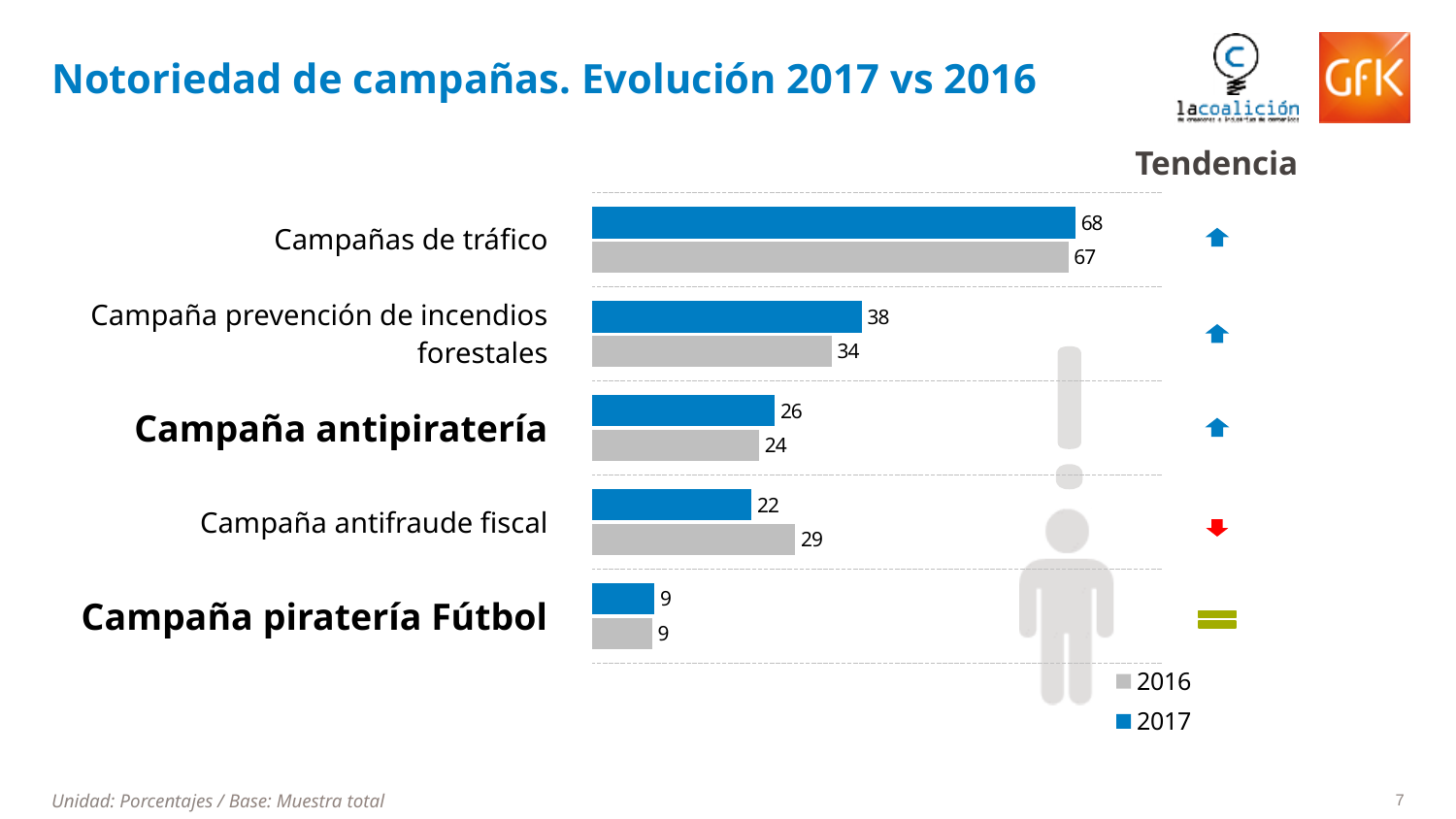
What is the difference between the 2017 and 2016 values for Campaña antipiratería? 2 Which colour represents 2017 in the chart? Blue What is the difference between the 2016 and 2017 values for Campaña antifraude fiscal? 7 What kind of chart is shown on the slide? Bar chart Which campaign has the lowest 2016 value? Campaña piratería Fútbol Which is larger for Campaña antifraude fiscal, the 2016 value or the 2017 value? 2016 What is the 2017 value for Campaña prevención de incendios forestales? 38 How many series does the legend list? 2 How many campaigns are shown in the chart? 5 Which campaign has the highest 2017 value? Campañas de tráfico What is the 2016 value for Campaña antifraude fiscal? 29 What is the 2017 value for Campañas de tráfico? 68